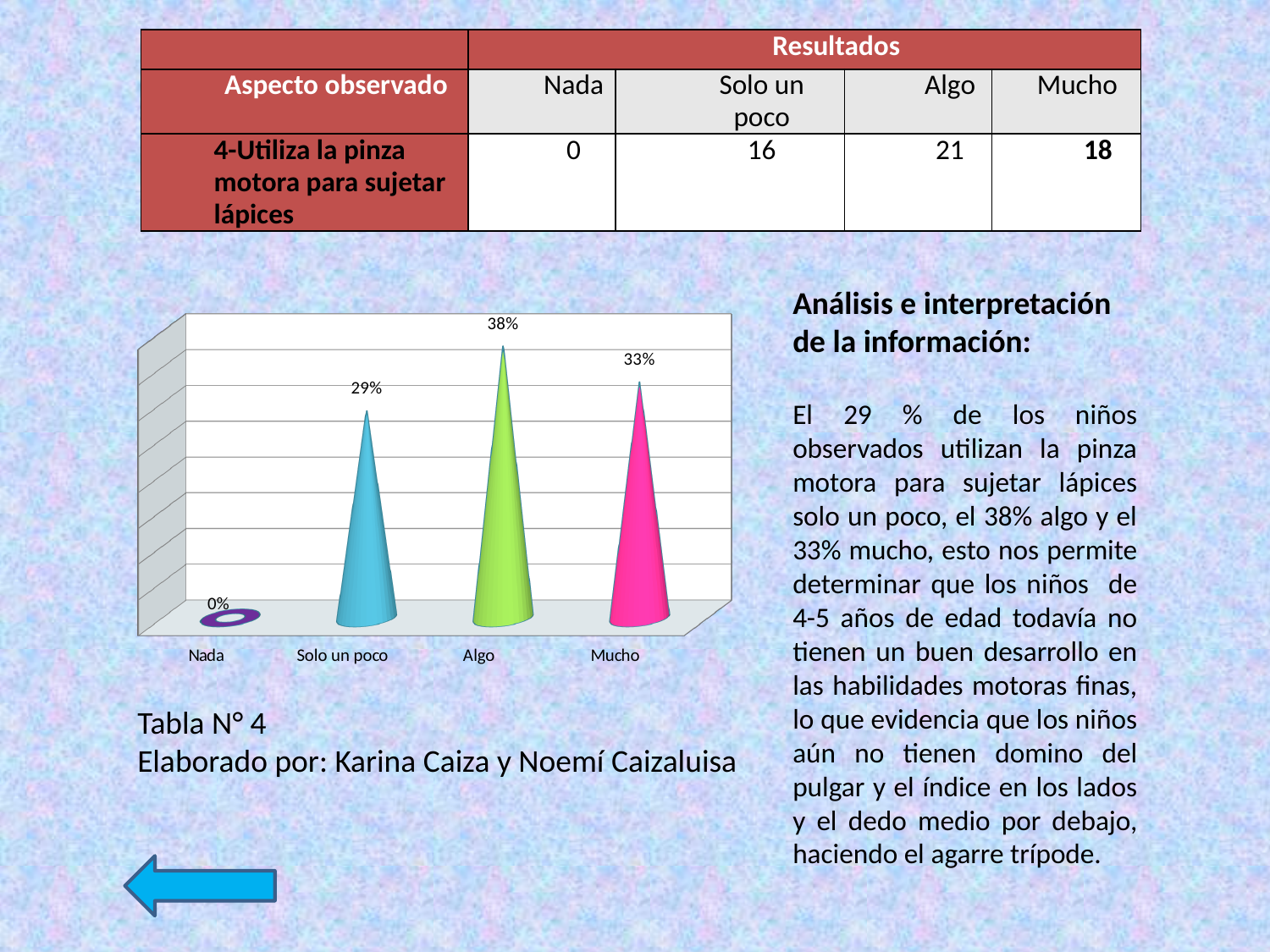
Which category has the highest value in the chart? Algo What is the difference between the values for Mucho and Solo un poco? 4% Which is larger, the value for Solo un poco or the value for Mucho? Mucho Which category has the lowest value in the chart? Nada What is the difference between the values for Algo and Mucho? 5% What is the value shown for Nada in the chart? 0% What is the value shown for Algo in the chart? 38% What is the value shown for Solo un poco in the chart? 29% What kind of chart is shown on the slide? Bar chart What colour is the bar for Algo in the chart? Green How many categories are shown on the x axis of the chart? 4 What is the value shown for Mucho in the chart? 33%